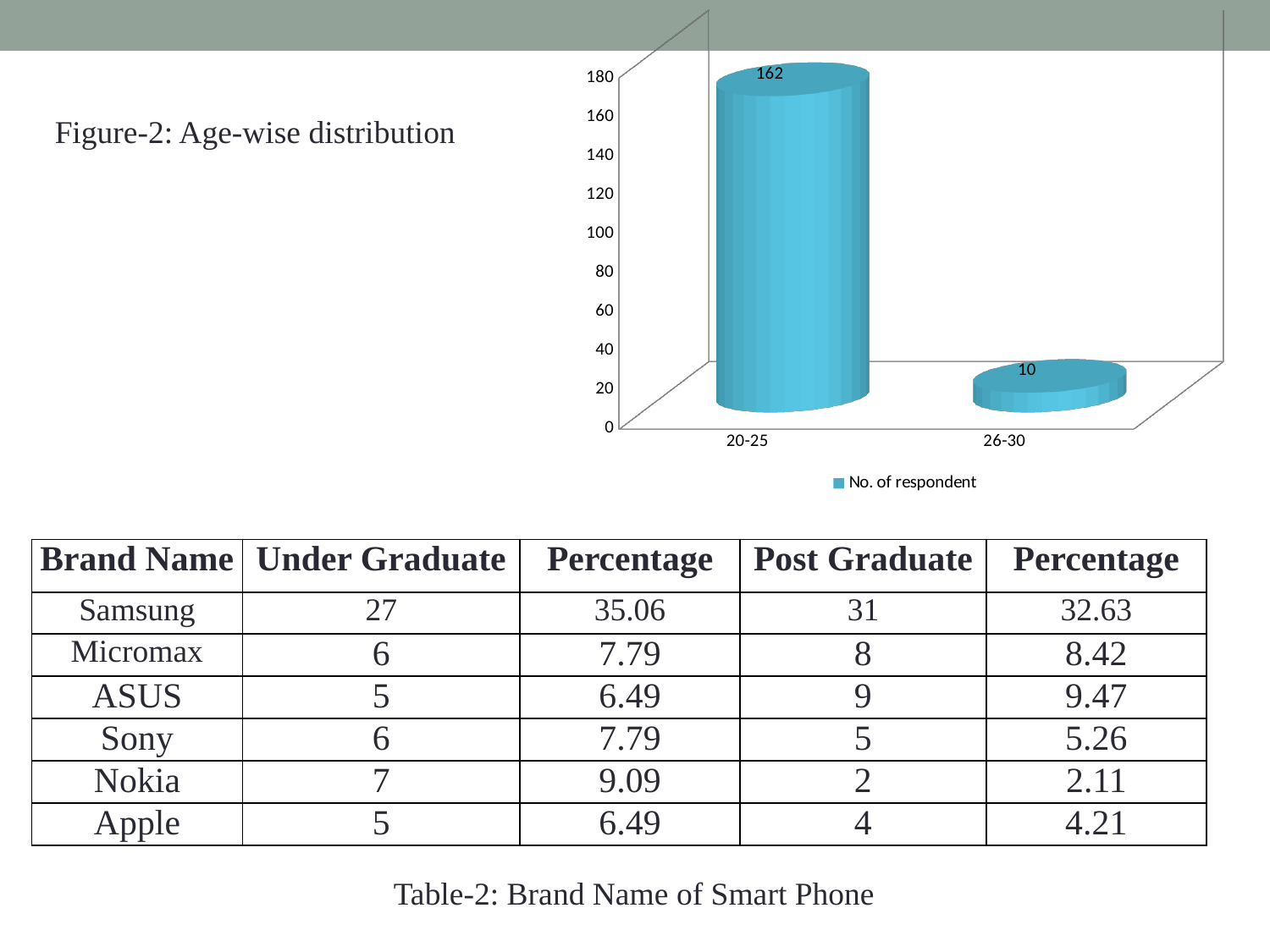
What is the number of respondents for the 20-25 age group? 162 What is the difference in number of respondents between the 20-25 and 26-30 age groups? 152 What is the number of respondents for the 26-30 age group? 10 Which age group has the lowest number of respondents? 26-30 How many age groups are shown in the chart? 2 Is the value for the 26-30 age group greater or less than 20? less Which age group has the highest number of respondents? 20-25 Which age group has more respondents, 20-25 or 26-30? 20-25 Is the value for the 20-25 age group greater or less than 140? greater What is the name of the series shown in the chart legend? No. of respondent How many series does the chart legend list? 1 What type of chart is used for the age-wise distribution? Bar chart